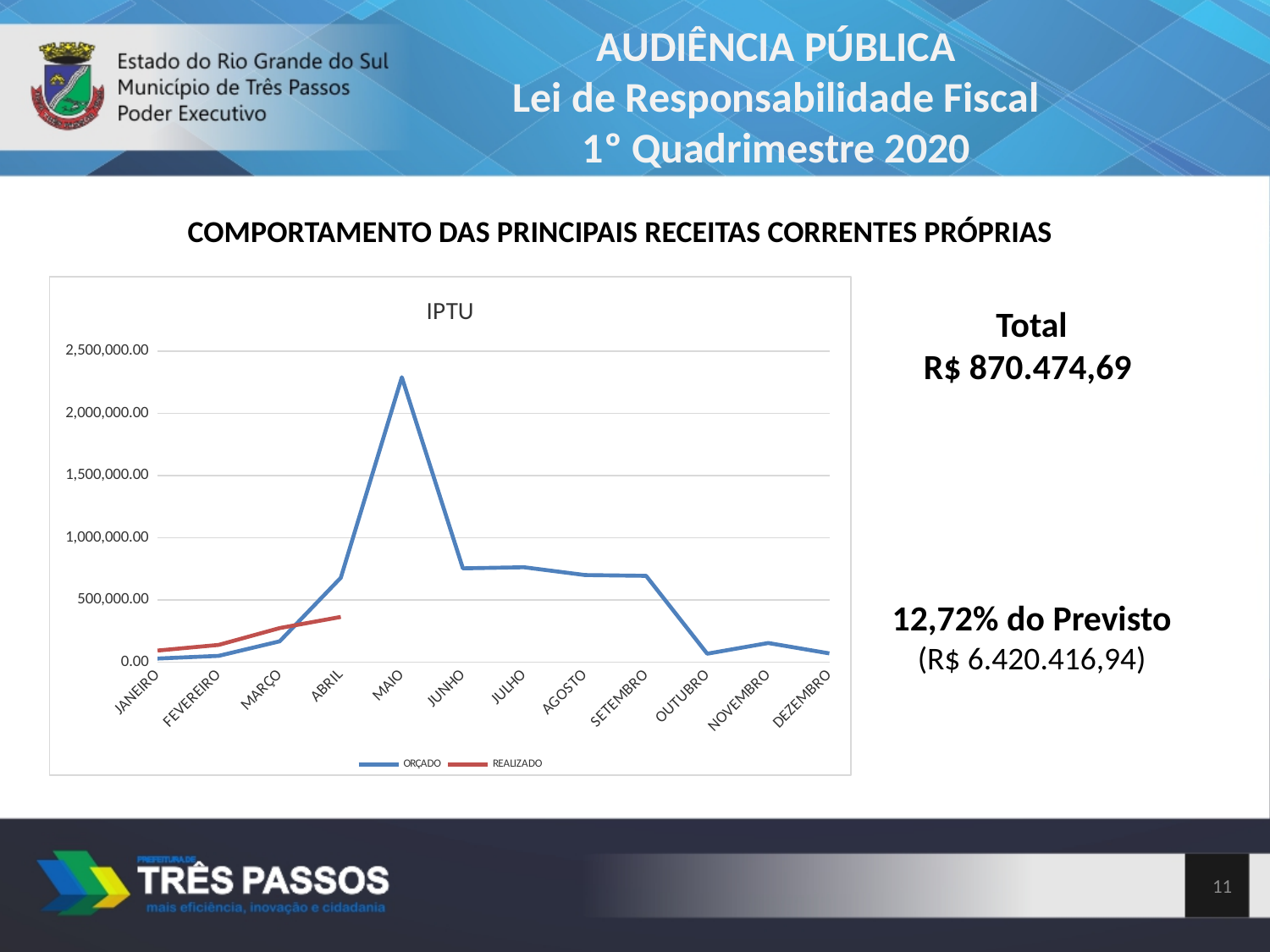
What is the title of the chart? IPTU Is the ORÇADO value for MAIO greater or less than 2,000,000.00? greater How many months are shown on the x axis of the IPTU chart? 12 Is the REALIZADO value for ABRIL greater or less than 500,000.00? less Does the ORÇADO series rise or fall from MAIO to OUTUBRO? fall Is the ORÇADO value for JUNHO greater or less than 1,000,000.00? less In which month does the ORÇADO series reach its highest value? MAIO In ABRIL, which series has the larger value, ORÇADO or REALIZADO? ORÇADO What kind of chart is shown on the slide? line chart How many series does the legend of the IPTU chart list? 2 Does the REALIZADO series rise or fall from JANEIRO to ABRIL? rise